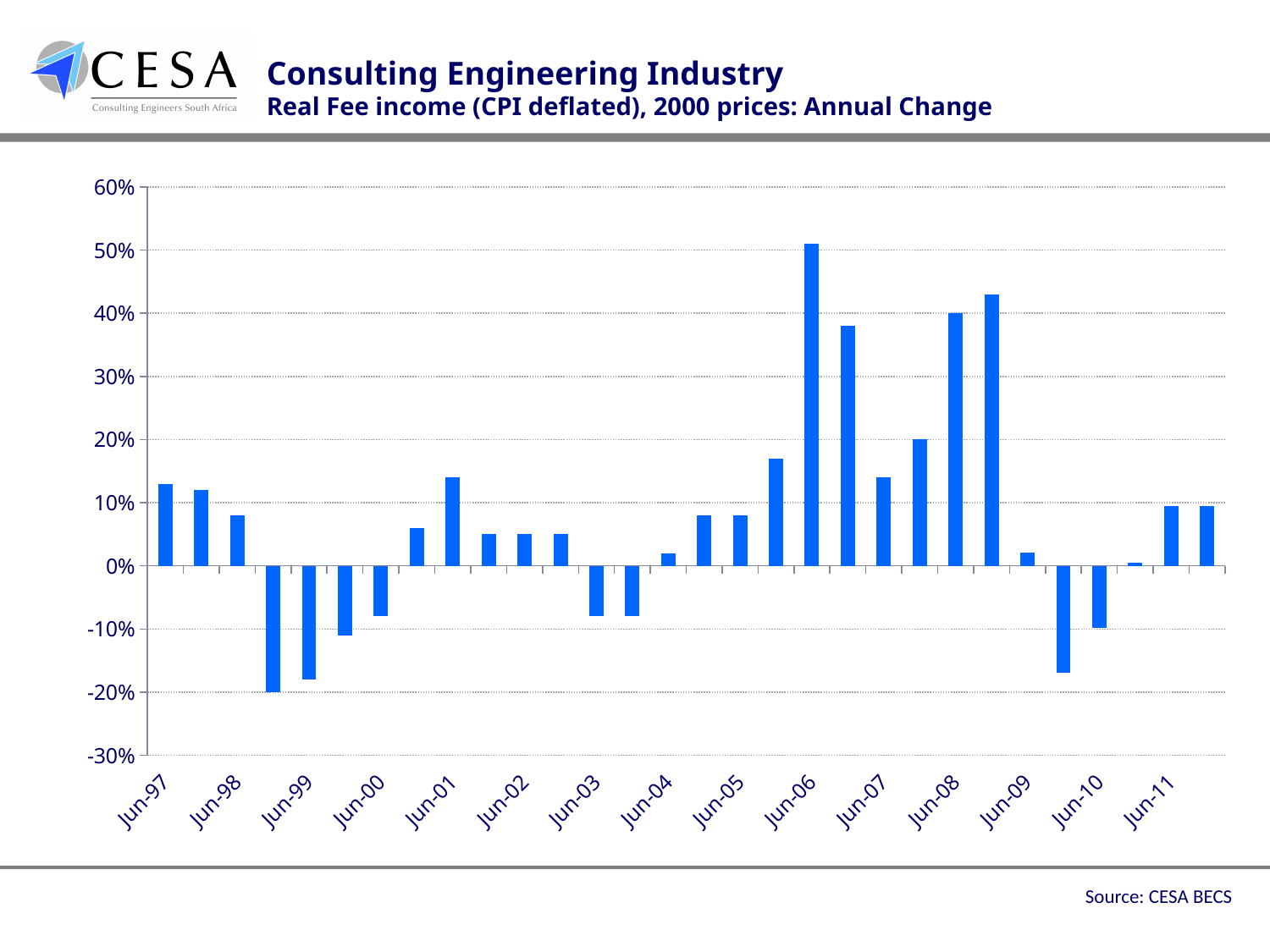
Is the value for Jun-08 greater or less than 30%? greater Is the value for Jun-01 greater or less than 10%? greater Which is larger, the value for Jun-06 or the value for Jun-08? Jun-06 Which is larger, the value for Jun-97 or the value for Jun-99? Jun-97 What source is cited for the chart? CESA BECS What kind of chart is shown on the slide? bar chart Is the value for Jun-06 greater or less than 40%? greater Which labelled period on the x axis has the highest annual change? Jun-06 How many period labels are shown on the x axis? 15